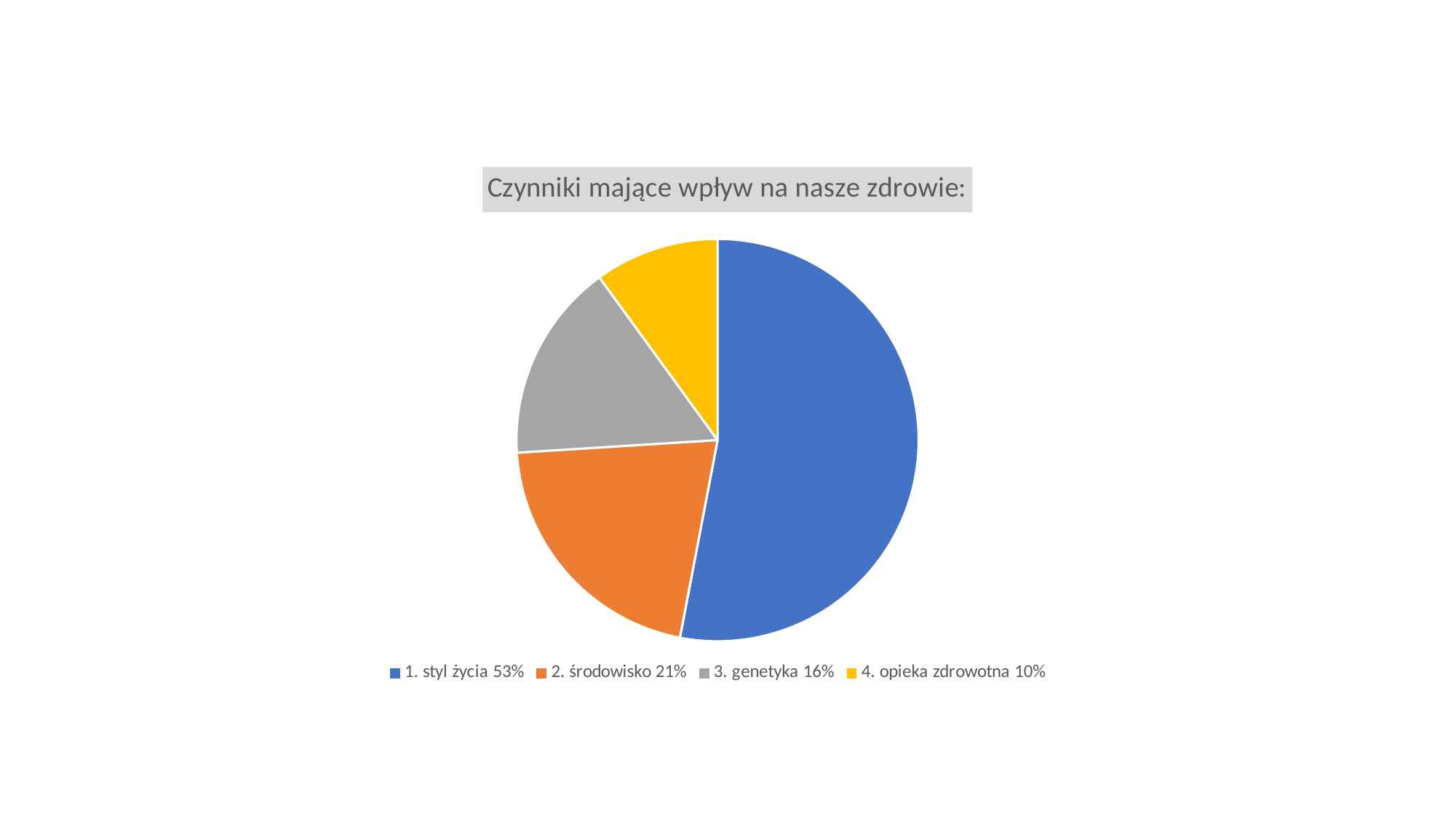
What share of the pie does 'styl życia' represent? 53% What colour is the slice for 'środowisko'? orange How many slices does the pie chart have? 4 What is the title of the chart? Czynniki mające wpływ na nasze zdrowie: Which category has the largest slice of the pie? styl życia What kind of chart is shown on the slide? pie chart What share of the pie does 'środowisko' represent? 21% What share of the pie does 'genetyka' represent? 16% Which is larger, the share for 'genetyka' or the share for 'opieka zdrowotna'? genetyka Which category has the smallest slice of the pie? opieka zdrowotna What is the difference in percentage points between 'styl życia' and 'środowisko'? 32